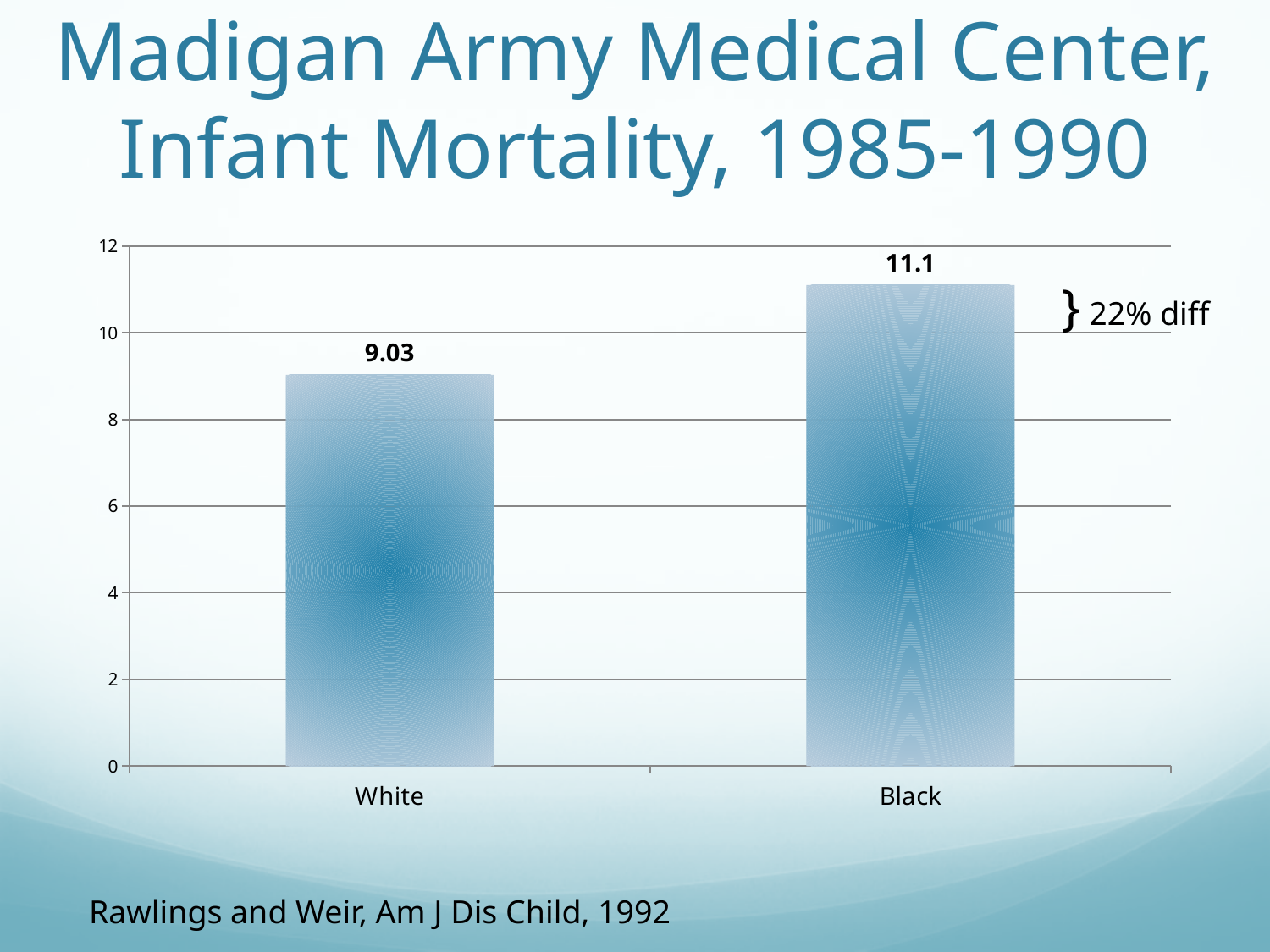
How many categories are shown on the chart? 2 Which category has the lowest infant mortality value? White What percentage difference is annotated next to the bars? 22% diff What is the infant mortality value for Black? 11.1 What is the maximum value shown on the vertical axis? 12 Is the value for Black greater or less than 10? greater What kind of chart is shown on the slide? bar chart What is the difference between the Black and White infant mortality values? 2.07 Is the value for White greater or less than 10? less Which is larger, the value for White or the value for Black? Black What is the infant mortality value for White? 9.03 Which category has the highest infant mortality value? Black